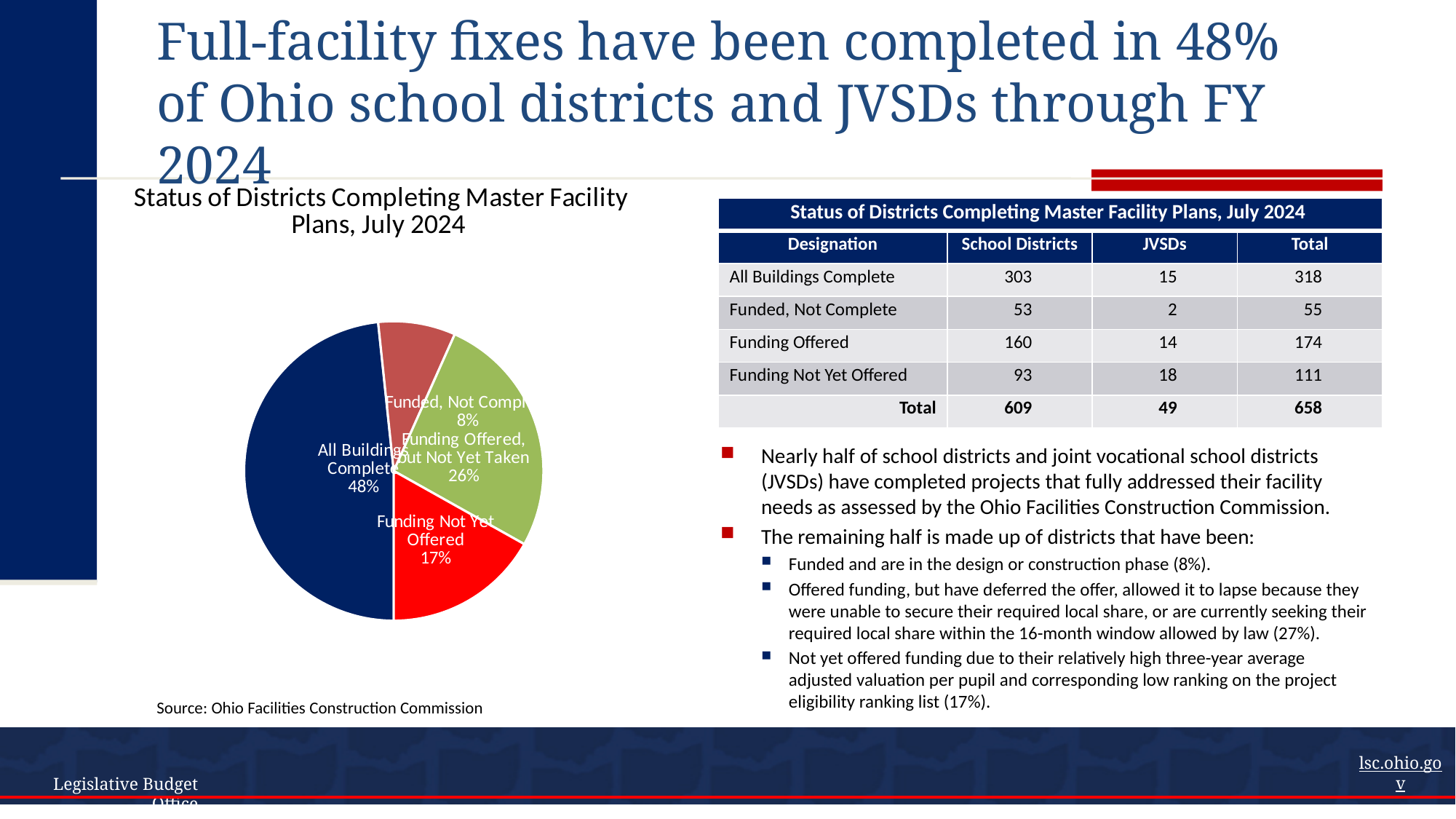
What colour is the All Buildings Complete slice in the pie chart? Dark navy blue What share of the pie chart is labelled All Buildings Complete? 48% What share of the pie chart is labelled Funding Offered, but Not Yet Taken? 26% In the pie chart, what is the difference in percentage points between All Buildings Complete and Funding Not Yet Offered? 31 percentage points What share of the pie chart is labelled Funding Not Yet Offered? 17% What type of chart is shown on the slide? Pie chart What is the title of the pie chart? Status of Districts Completing Master Facility Plans, July 2024 Which slice of the pie chart is the largest? All Buildings Complete In the pie chart, which is larger: Funding Offered, but Not Yet Taken or Funding Not Yet Offered? Funding Offered, but Not Yet Taken How many slices does the pie chart have? 4 Which slice of the pie chart is the smallest? Funded, Not Complete